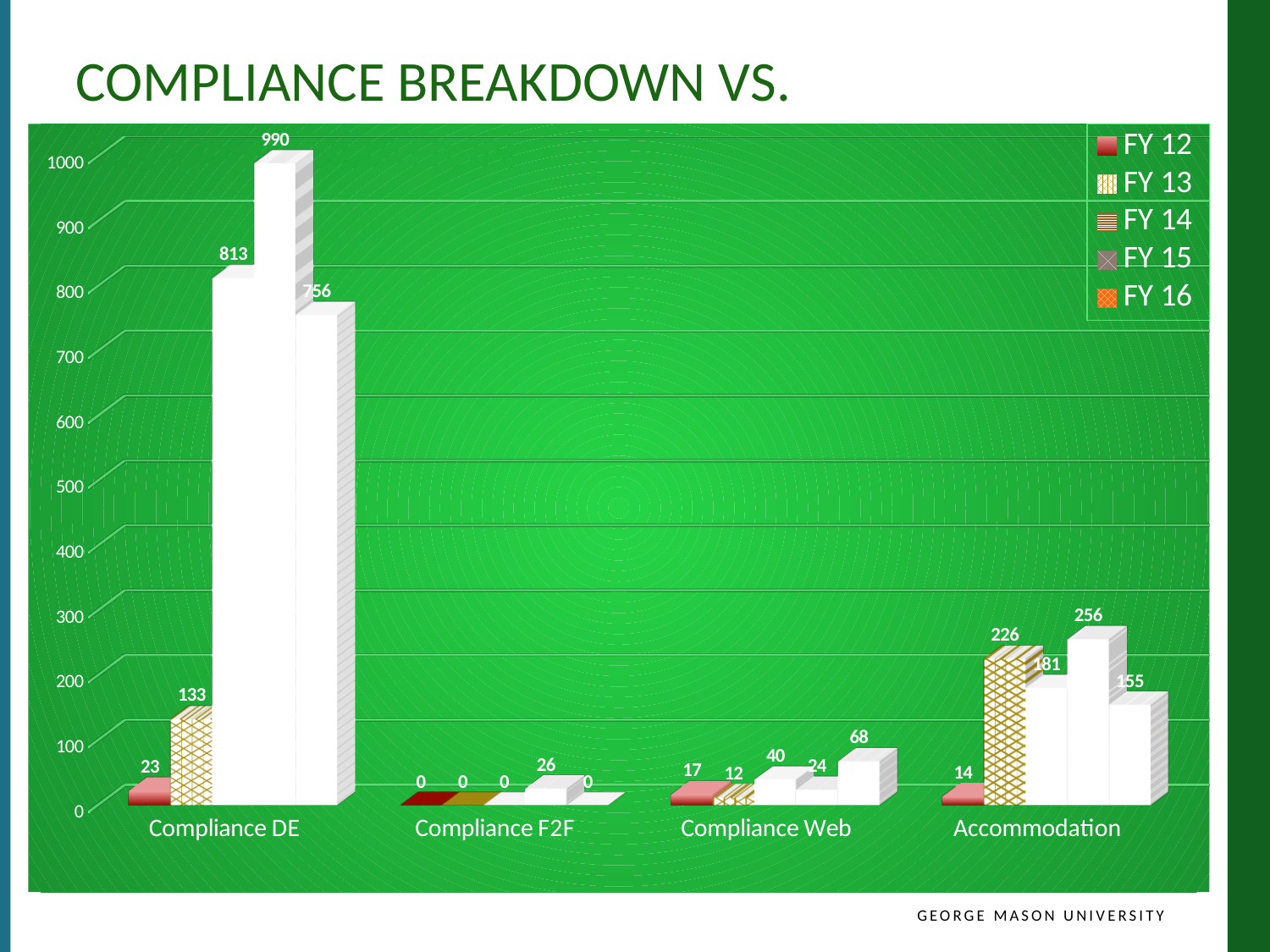
Which category has the highest FY 15 value? Compliance DE Which is larger for Accommodation, the FY 15 value or the FY 16 value? FY 15 What is the FY 14 value for Compliance DE? 813 What is the FY 13 value for Accommodation? 226 Which category has the lowest FY 16 value? Compliance F2F What is the difference between the FY 15 and FY 14 values for Compliance DE? 177 What is the FY 15 value for Compliance DE? 990 What kind of chart is shown on the slide? Bar chart How many series does the legend list? 5 What is the FY 15 value for Compliance F2F? 26 What is the FY 16 value for Compliance Web? 68 How many categories are shown on the x axis? 4